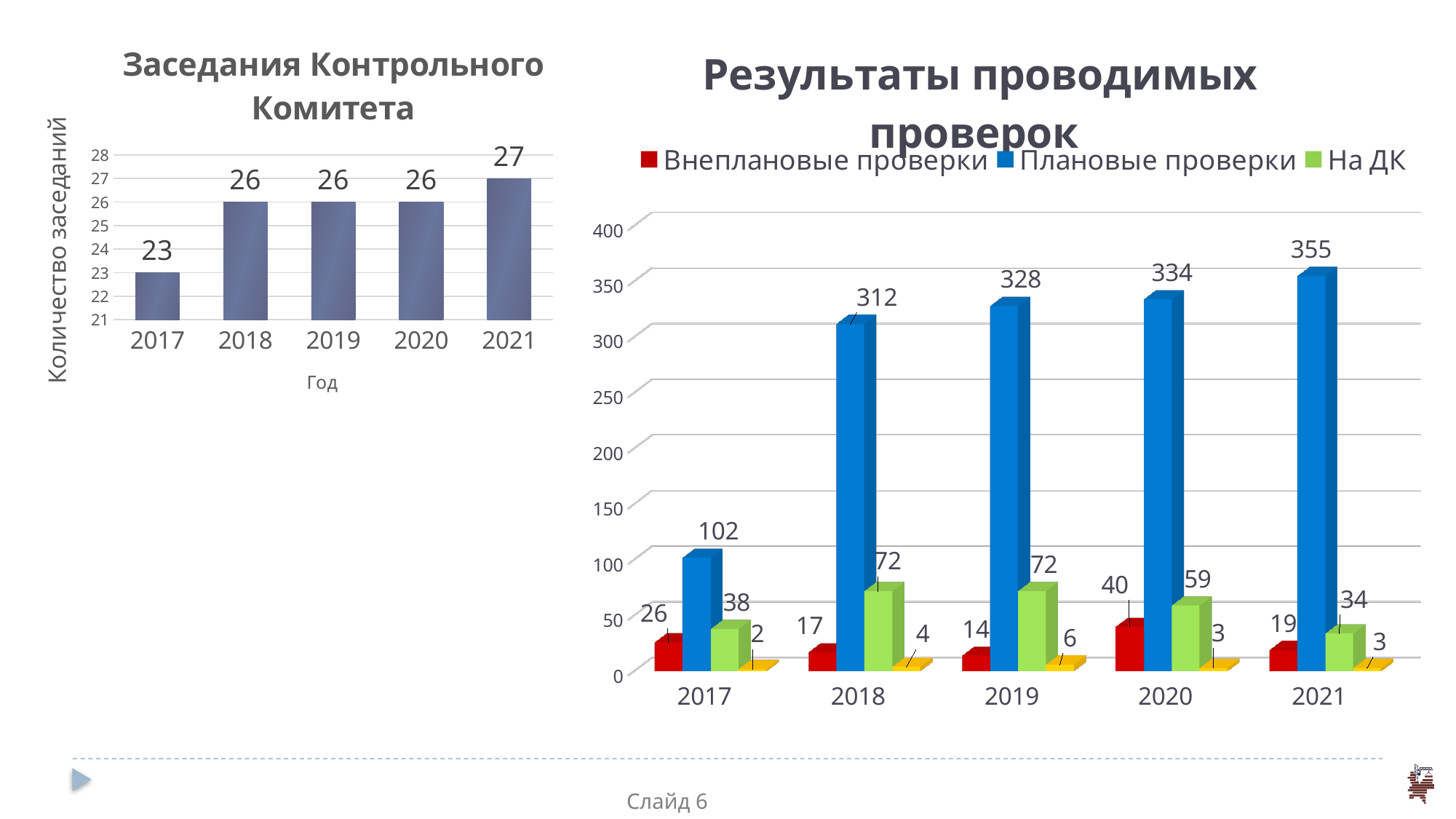
In the chart 'Результаты проводимых проверок', what is the difference between 'Плановые проверки' in 2021 and in 2020? 21 What kind of chart is 'Результаты проводимых проверок'? Bar chart In the chart 'Результаты проводимых проверок', which is larger: 'На ДК' in 2020 or 'На ДК' in 2021? 2020 In the chart 'Результаты проводимых проверок', what is the value of 'Плановые проверки' for 2019? 328 In the chart 'Заседания Контрольного Комитета', which year has the lowest value? 2017 In the chart 'Результаты проводимых проверок', what is the value of 'Внеплановые проверки' for 2020? 40 In the chart 'Заседания Контрольного Комитета', what is the value for 2017? 23 In the chart 'Заседания Контрольного Комитета', which year has the highest value? 2021 In the chart 'Заседания Контрольного Комитета', how many years are shown on the x axis? 5 In the chart 'Заседания Контрольного Комитета', what is the difference between the values for 2021 and 2017? 4 In the chart 'Результаты проводимых проверок', in which year is 'Плановые проверки' the lowest? 2017 In the chart 'Результаты проводимых проверок', what is the value of 'На ДК' for 2018? 72